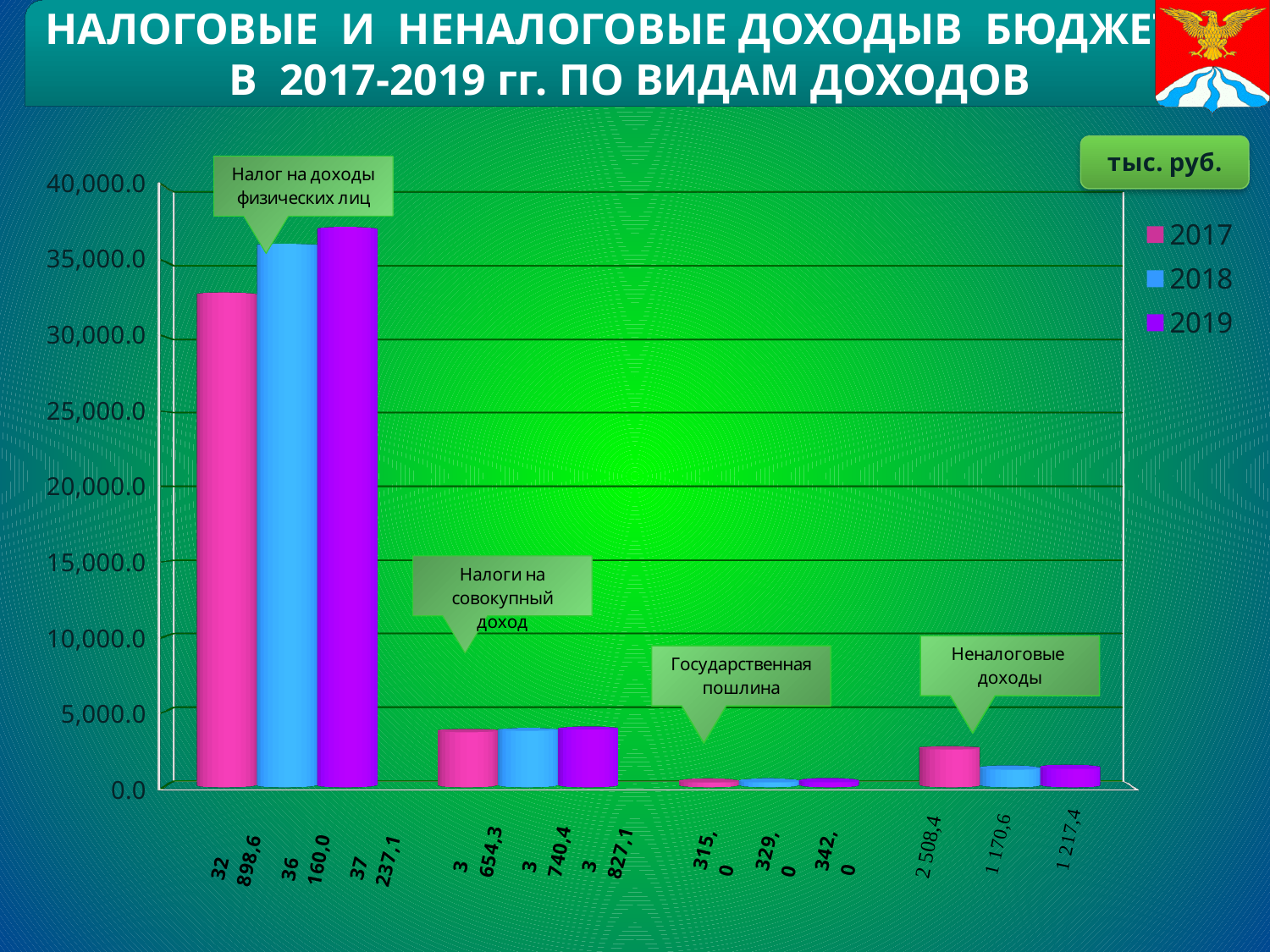
What is the 2018 value for Налоги на совокупный доход? 3 740,4 For Налог на доходы физических лиц, which year has the highest value? 2019 What kind of chart is shown on the slide? bar chart How many income categories are shown in the chart? 4 Do the values for Налог на доходы физических лиц rise or fall from 2017 to 2019? rise Is the 2017 value for Налог на доходы физических лиц greater or less than 35,000.0? less What is the difference between the 2019 and 2018 values for Государственная пошлина? 13,0 What is the 2017 value for Неналоговые доходы? 2 508,4 What is the 2019 value for Налог на доходы физических лиц? 37 237,1 How many series does the legend list? 3 Which income category has the lowest values in the chart? Государственная пошлина For Неналоговые доходы, which is larger: the 2017 value or the 2018 value? 2017